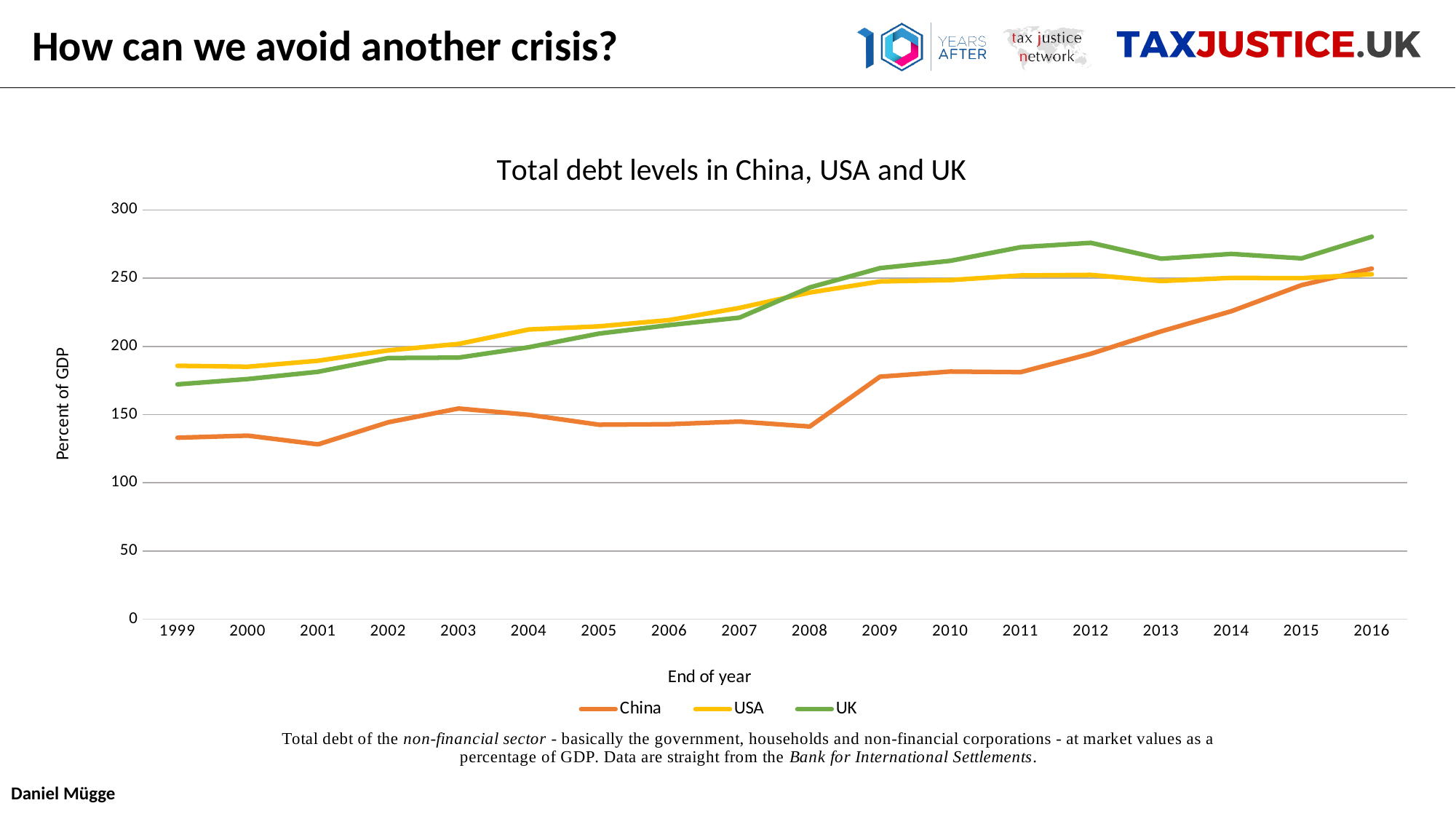
How many series does the legend list? 3 Which series has the highest value in 2016? UK How many years are plotted along the x axis? 18 Is the value for the UK in 2016 greater or less than 250? greater What kind of chart is shown on the slide? Line chart Does the value for China rise or fall from 2008 to 2016? Rises What is the label of the y axis? Percent of GDP Is the value for the USA in 1999 greater or less than 200? less In 2010, which is larger, the value for the UK or the value for China? UK Is the value for China in 1999 greater or less than 150? less Which series has the lowest value in 2005? China What is the title of the chart? Total debt levels in China, USA and UK